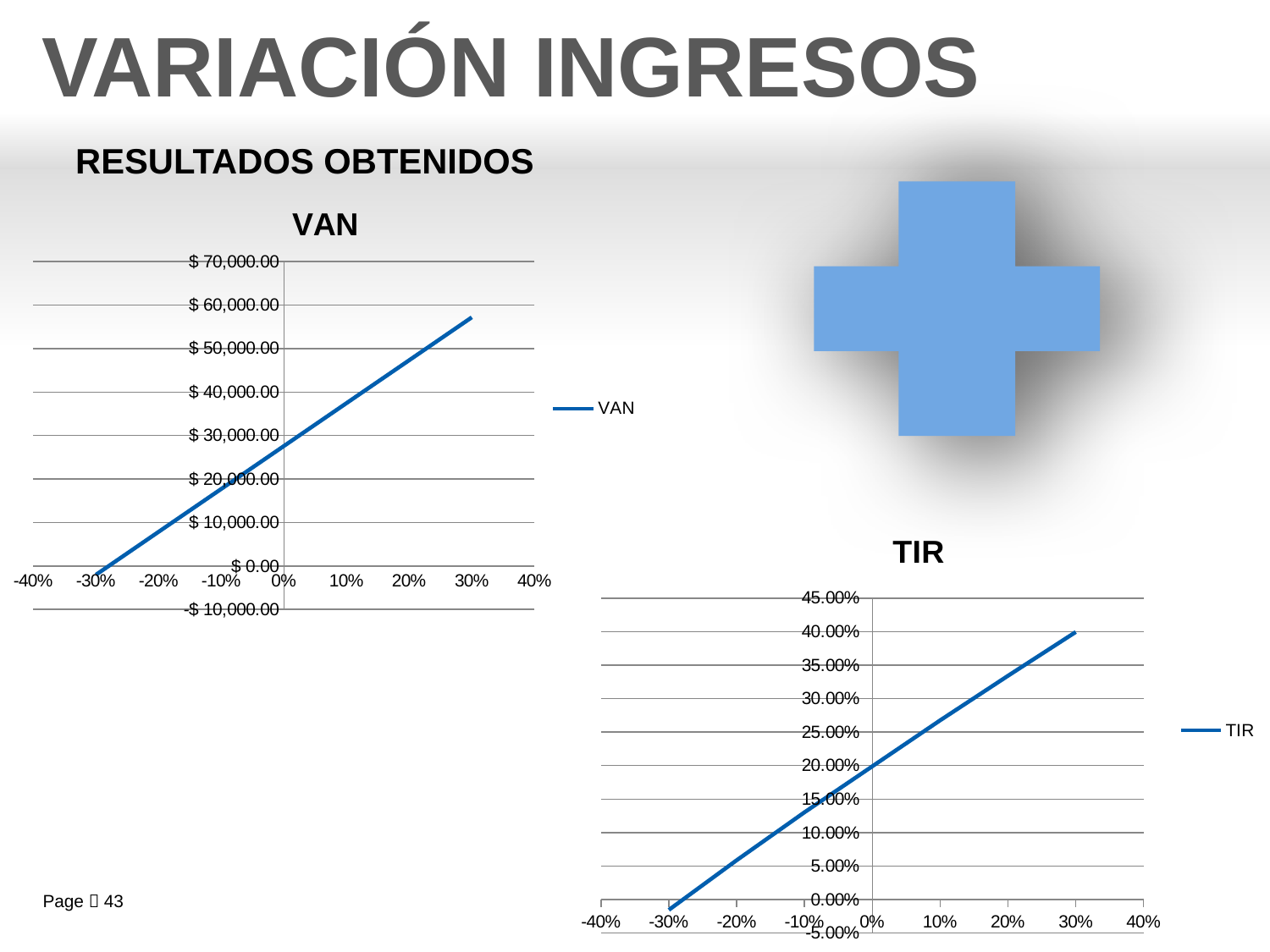
In the VAN chart, is the value at 30% greater or less than $ 50,000.00? greater In the VAN chart, is the value at -20% greater or less than $ 20,000.00? less What kind of chart is the VAN chart? line chart What is the legend entry of the chart on the right side of the slide? TIR In the TIR chart, do the values rise or fall as the x axis goes from -30% to 30%? rise In the TIR chart, is the value at 30% greater or less than 35.00%? greater What kind of chart is the TIR chart? line chart In the VAN chart, do the values rise or fall as the x axis goes from -30% to 30%? rise How many series does the legend of the TIR chart list? 1 How many series does the legend of the VAN chart list? 1